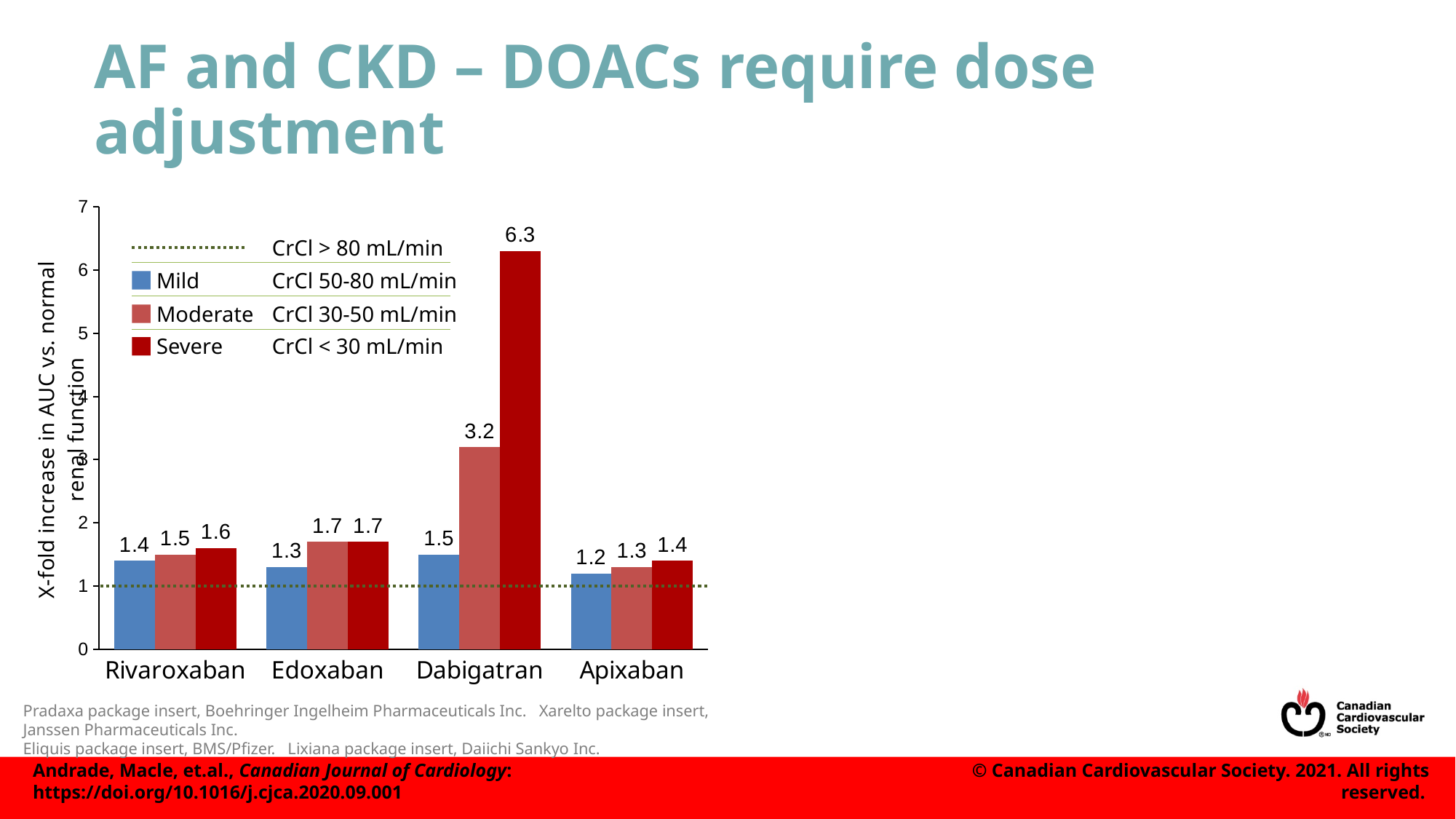
What is the difference between the Severe and Moderate values for Dabigatran? 3.1 What kind of chart is shown on the slide? Bar chart What is the value for Edoxaban in the Moderate series? 1.7 Which drug has the lowest value in the Mild series? Apixaban What is the value for Dabigatran in the Severe series? 6.3 What is the value for Apixaban in the Mild series? 1.2 Which is larger: the Severe value for Rivaroxaban or the Severe value for Edoxaban? Edoxaban Is the Moderate value for Dabigatran greater or less than 3? greater How many bar series (renal impairment categories) does the legend list? 3 What CrCl range does the legend give for the Moderate category? CrCl 30-50 mL/min How many drugs are shown on the x axis? 4 Which drug has the highest value in the Severe series? Dabigatran